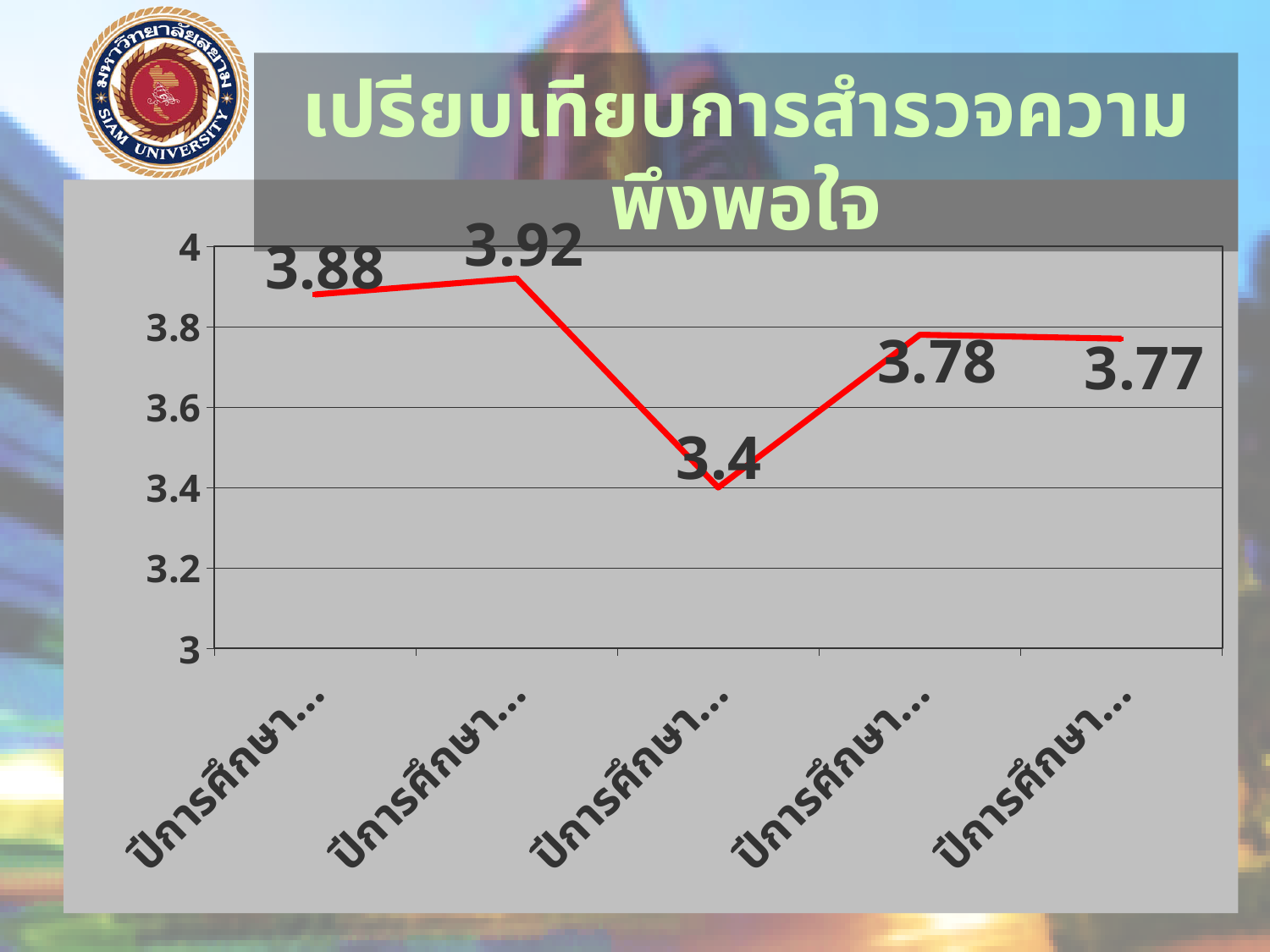
Which data point has the highest value on the line chart? the second point (3.92) What colour is the line in the chart? red What is the value of the last data point on the line chart? 3.77 What is the value of the third (middle) data point on the line chart? 3.4 Which is larger, the value of the first data point or the value of the fourth data point? the first data point (3.88) What is the difference between the highest value (3.92) and the lowest value (3.4) on the chart? 0.52 How many data points are plotted on the line chart? 5 Does the line rise or fall between the second and third data points? fall What is the value of the first data point on the line chart? 3.88 What type of chart is shown on the slide? line chart What is the value of the second data point on the line chart? 3.92 Which data point has the lowest value on the line chart? the third point (3.4)